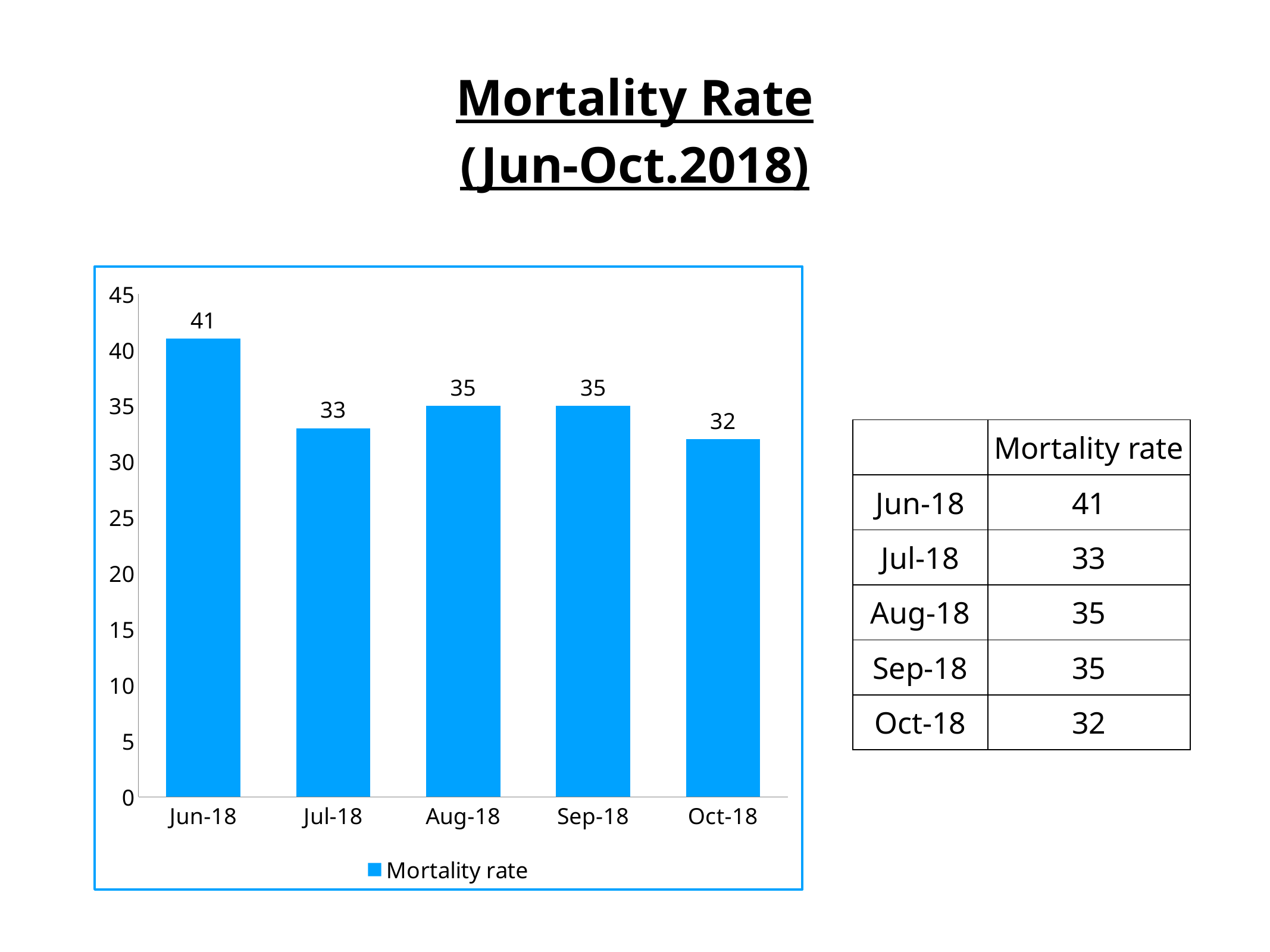
What is the mortality rate for Oct-18? 32 What is the mortality rate for Jun-18? 41 How many months are shown on the x axis of the chart? 5 What kind of chart is shown on the slide? bar chart What is the difference between the mortality rate in Jun-18 and Jul-18? 8 Which month has the lowest mortality rate? Oct-18 Is the value for Jun-18 greater or less than 40? greater Which month has the highest mortality rate? Jun-18 Which is larger, the mortality rate for Jul-18 or for Sep-18? Sep-18 What is the mortality rate for Jul-18? 33 What is the difference between the mortality rate in Aug-18 and Oct-18? 3 What series name does the chart legend show? Mortality rate